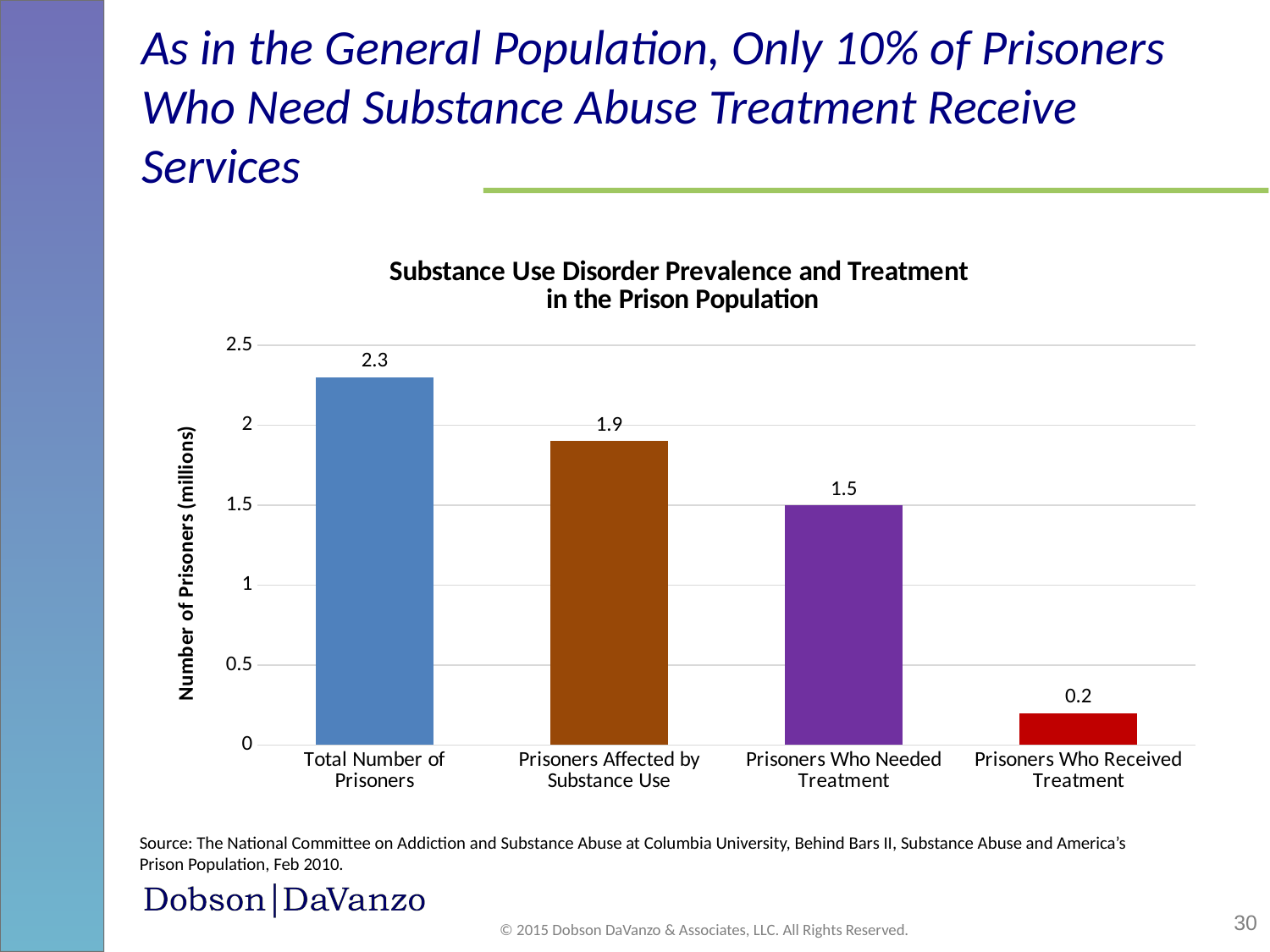
Which category has the lowest value? Prisoners Who Received Treatment What is the difference between Prisoners Who Needed Treatment and Prisoners Who Received Treatment? 1.3 Which is larger: Prisoners Affected by Substance Use or Prisoners Who Needed Treatment? Prisoners Affected by Substance Use Is the value for Prisoners Who Received Treatment greater or less than 0.5? less How many categories are shown in the chart? 4 What is the value for Prisoners Affected by Substance Use? 1.9 What is the label of the vertical axis? Number of Prisoners (millions) What is the value for Prisoners Who Needed Treatment? 1.5 Which category has the highest value? Total Number of Prisoners What is the value for Prisoners Who Received Treatment? 0.2 What is the value for Total Number of Prisoners? 2.3 What kind of chart is shown on the slide? bar chart